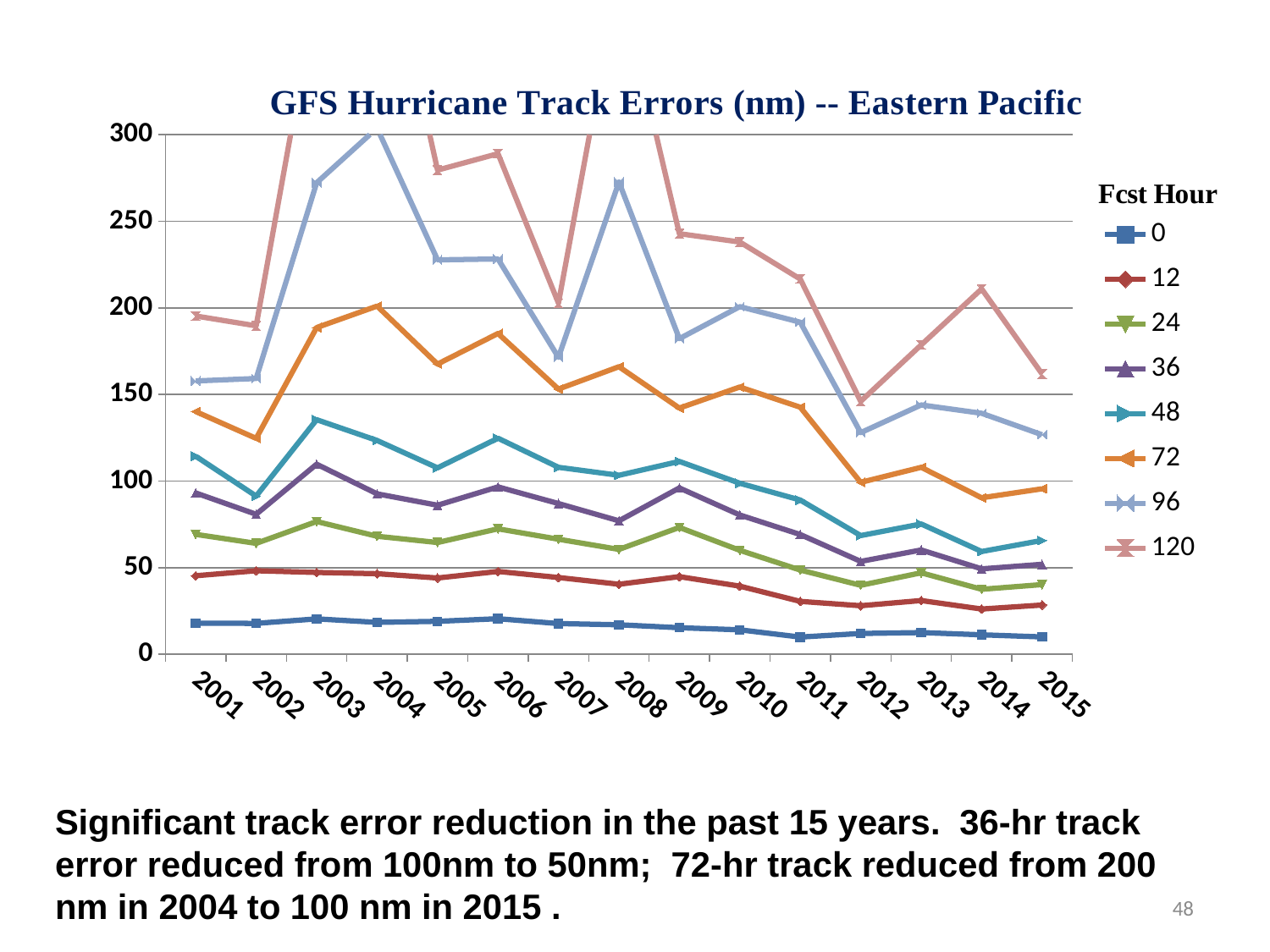
What is the title of the legend? Fcst Hour Is the value for the 0 forecast hour series in 2015 greater or less than 50? less Is the value for the 120 forecast hour series in 2001 greater or less than 150? greater Which forecast hour series has the lowest value in 2001? 0 In 2008, which is larger: the value for the 96 forecast hour series or the 72 forecast hour series? 96 What is the title of the chart? GFS Hurricane Track Errors (nm) -- Eastern Pacific Is the value for the 48 forecast hour series in 2003 greater or less than 100? greater Which forecast hour series has the highest value in 2015? 120 What kind of chart is shown on the slide? line chart How many series does the legend list? 8 How many years are plotted along the x axis? 15